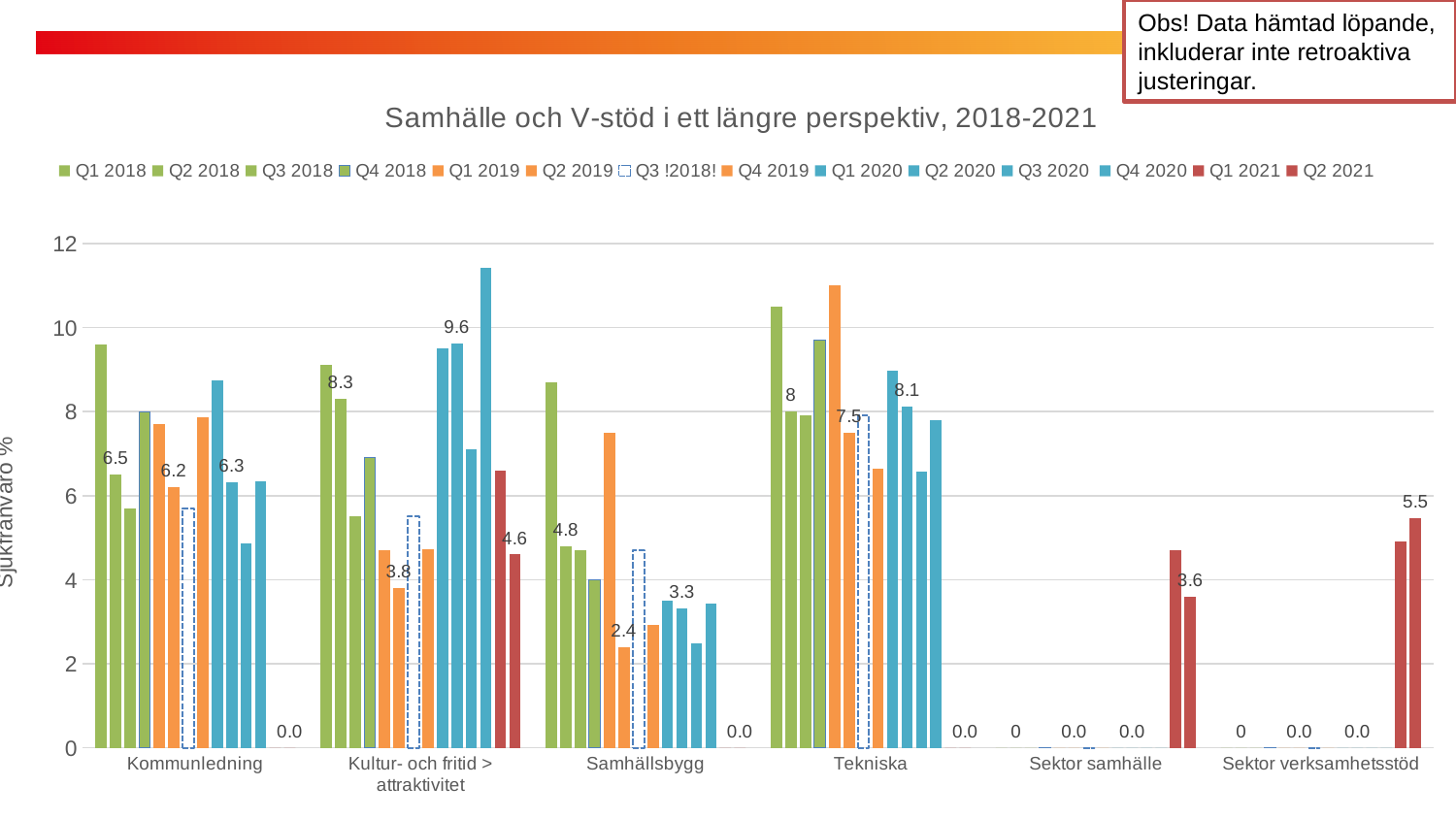
Is the Q1 2018 value for Tekniska greater or less than 10? greater Which is larger: the Q2 2020 value for Tekniska or the Q2 2020 value for Kommunledning? Tekniska What is the label on the vertical axis? Sjukfrånvaro % What is the labelled value for Q2 2021 in the Sektor samhälle category? 3.6 What kind of chart is shown on the slide? bar chart What is the labelled value for Q2 2019 in the Samhällsbygg category? 2.4 How many series does the legend list? 14 What is the labelled value for Q2 2018 in the Kommunledning category? 6.5 What is the labelled value for Q2 2020 in the Kultur- och fritid > attraktivitet category? 9.6 What is the labelled value for Q2 2021 in the Sektor verksamhetsstöd category? 5.5 What is the difference between the Q2 2018 value (8.3) and the Q2 2019 value (3.8) for Kultur- och fritid > attraktivitet? 4.5 How many categories are shown on the x axis? 6